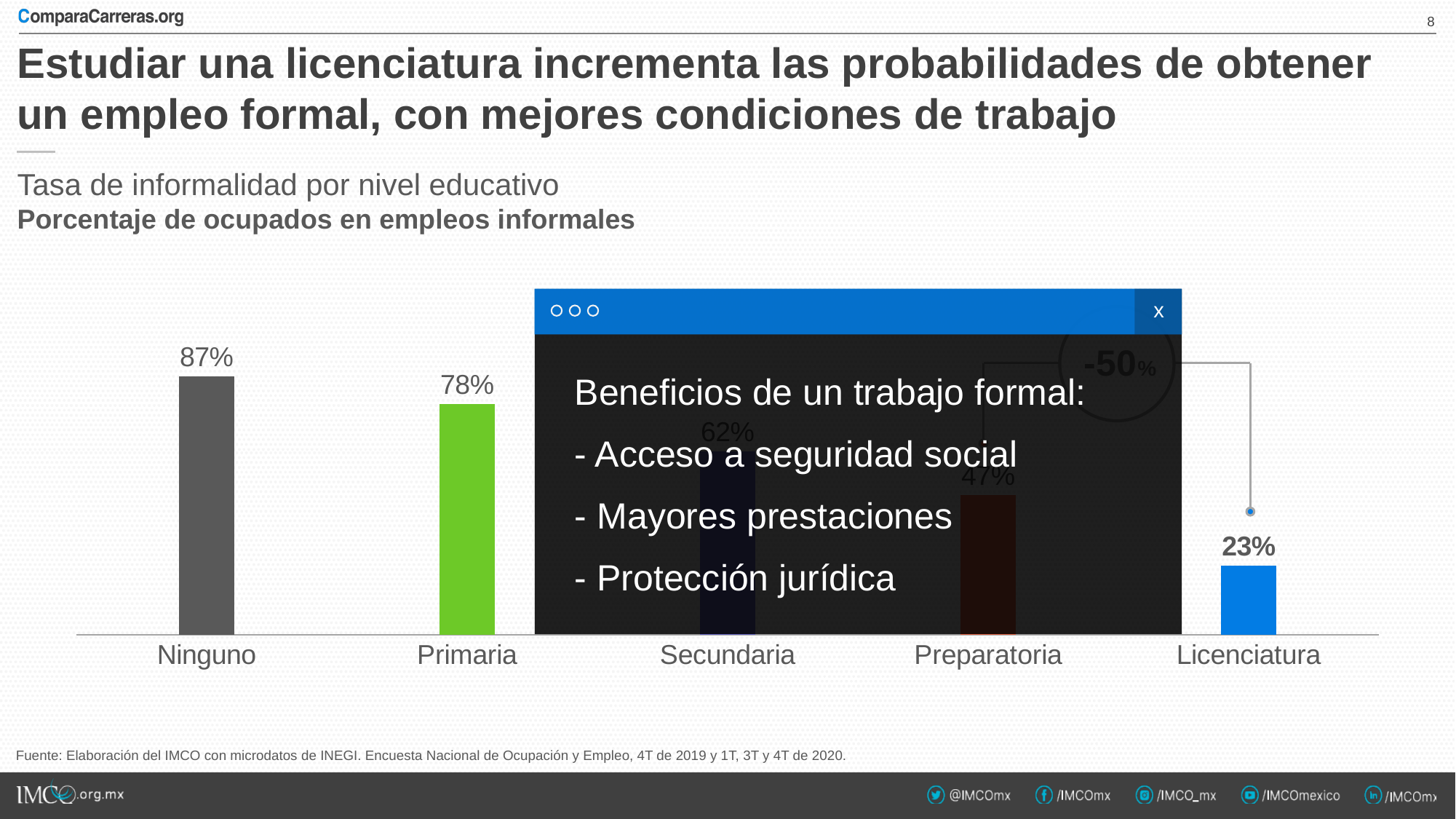
What is the title of the chart? Tasa de informalidad por nivel educativo What kind of chart is shown on the slide? Bar chart What is the informality rate for Licenciatura? 23% Do the informality rates rise or fall as education level increases from Ninguno to Licenciatura? Fall What is the informality rate for Primaria? 78% Which has a higher informality rate, Primaria or Licenciatura? Primaria What is the informality rate for Ninguno? 87% What is the difference between the informality rates for Ninguno and Licenciatura? 64 percentage points How many education levels are shown on the x axis? 5 What is the difference between the informality rates for Ninguno and Primaria? 9 percentage points Which education level has the highest informality rate? Ninguno Which education level has the lowest informality rate? Licenciatura